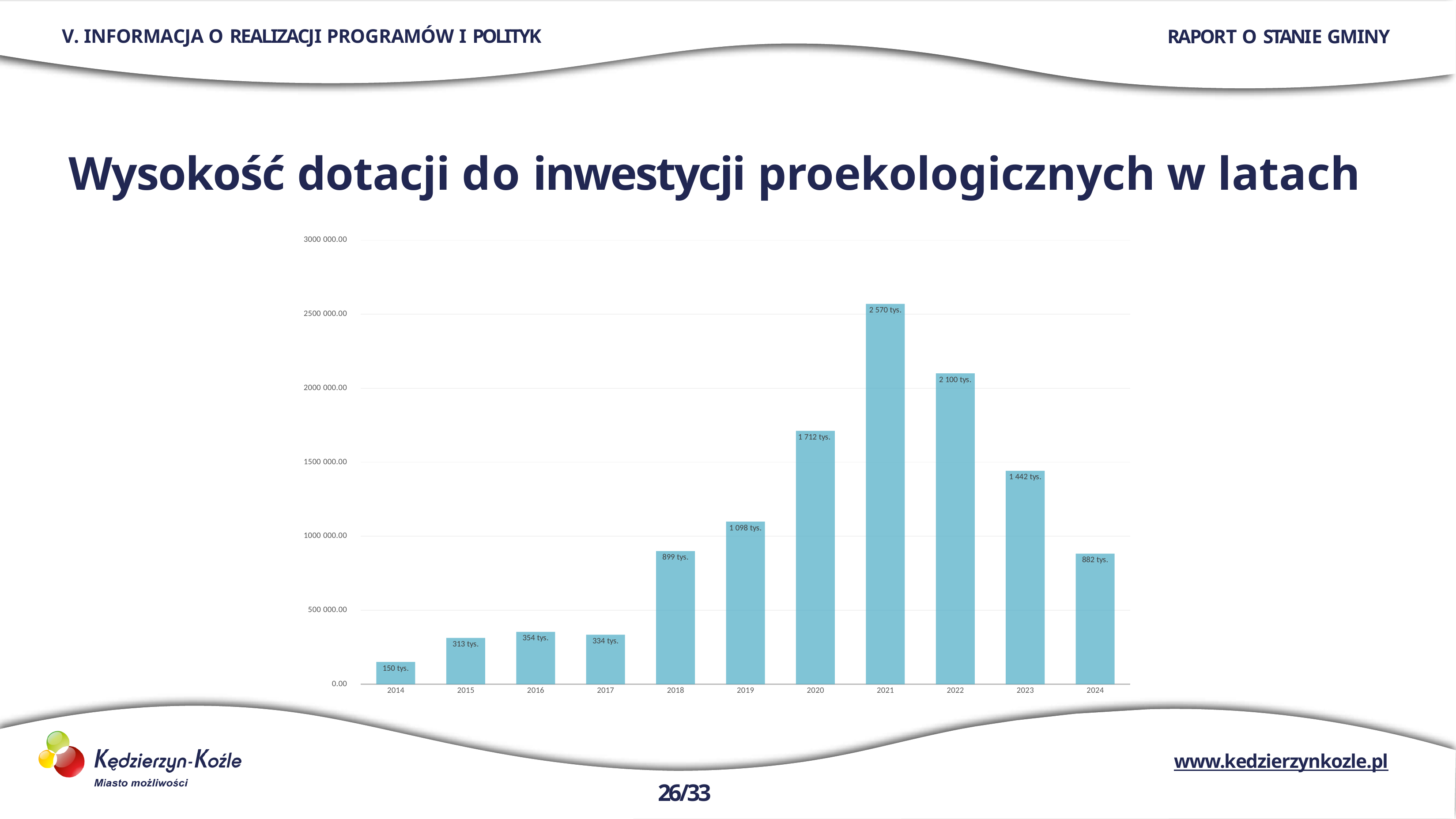
What is the title of the chart? Wysokość dotacji do inwestycji proekologicznych w latach What is the difference between the values for 2021 and 2022? 470 tys. What is the value for 2021? 2 570 tys. What is the value for 2024? 882 tys. Which is larger, the value for 2016 or the value for 2017? 2016 Is the value for 2020 greater or less than 1500 000.00? greater What is the value for 2014? 150 tys. How many years are shown on the x axis? 11 What kind of chart is shown on the slide? bar chart Do the values rise or fall from 2021 to 2024? fall Which year has the lowest value? 2014 Which year has the highest value? 2021